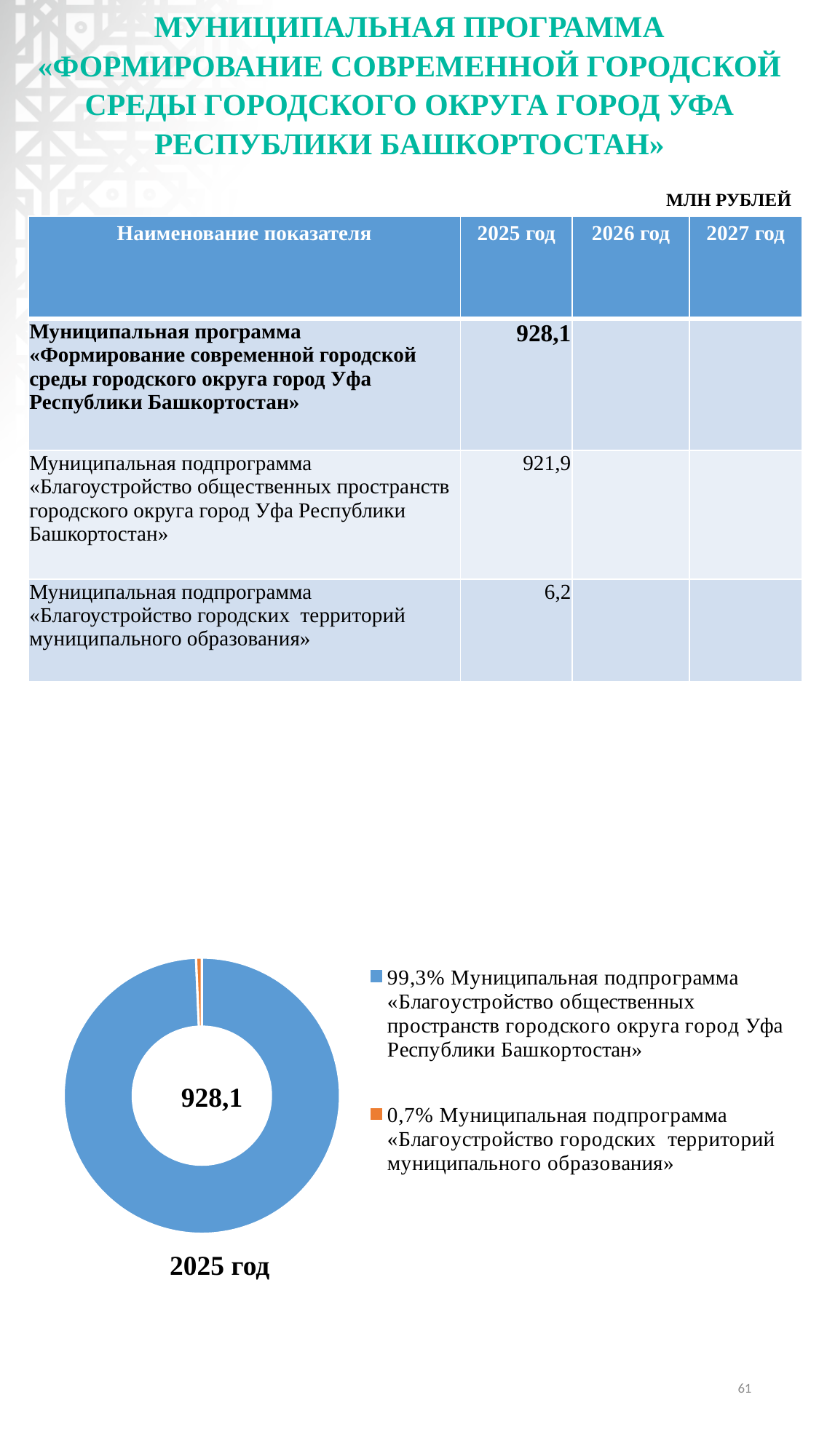
Which slice of the donut chart is the largest? Муниципальная подпрограмма «Благоустройство общественных пространств городского округа город Уфа Республики Башкортостан» How many entries does the legend of the donut chart list? 2 What is the difference in percentage points between the two slices of the donut chart? 98,6 What value is printed in the centre of the donut chart? 928,1 Which is larger in the donut chart: the share for «Благоустройство общественных пространств...» or the share for «Благоустройство городских территорий...»? «Благоустройство общественных пространств...» (99,3%) What kind of chart is shown at the bottom of the slide? Donut (pie) chart What share of the donut chart does the subprogram «Благоустройство городских территорий муниципального образования» take? 0,7% What year label is shown beneath the donut chart? 2025 год What share of the donut chart does the subprogram «Благоустройство общественных пространств городского округа город Уфа Республики Башкортостан» take? 99,3% Which slice of the donut chart is the smallest? Муниципальная подпрограмма «Благоустройство городских территорий муниципального образования» How many slices does the donut chart have? 2 What colour is the slice for the subprogram «Благоустройство городских территорий муниципального образования» in the donut chart? Orange